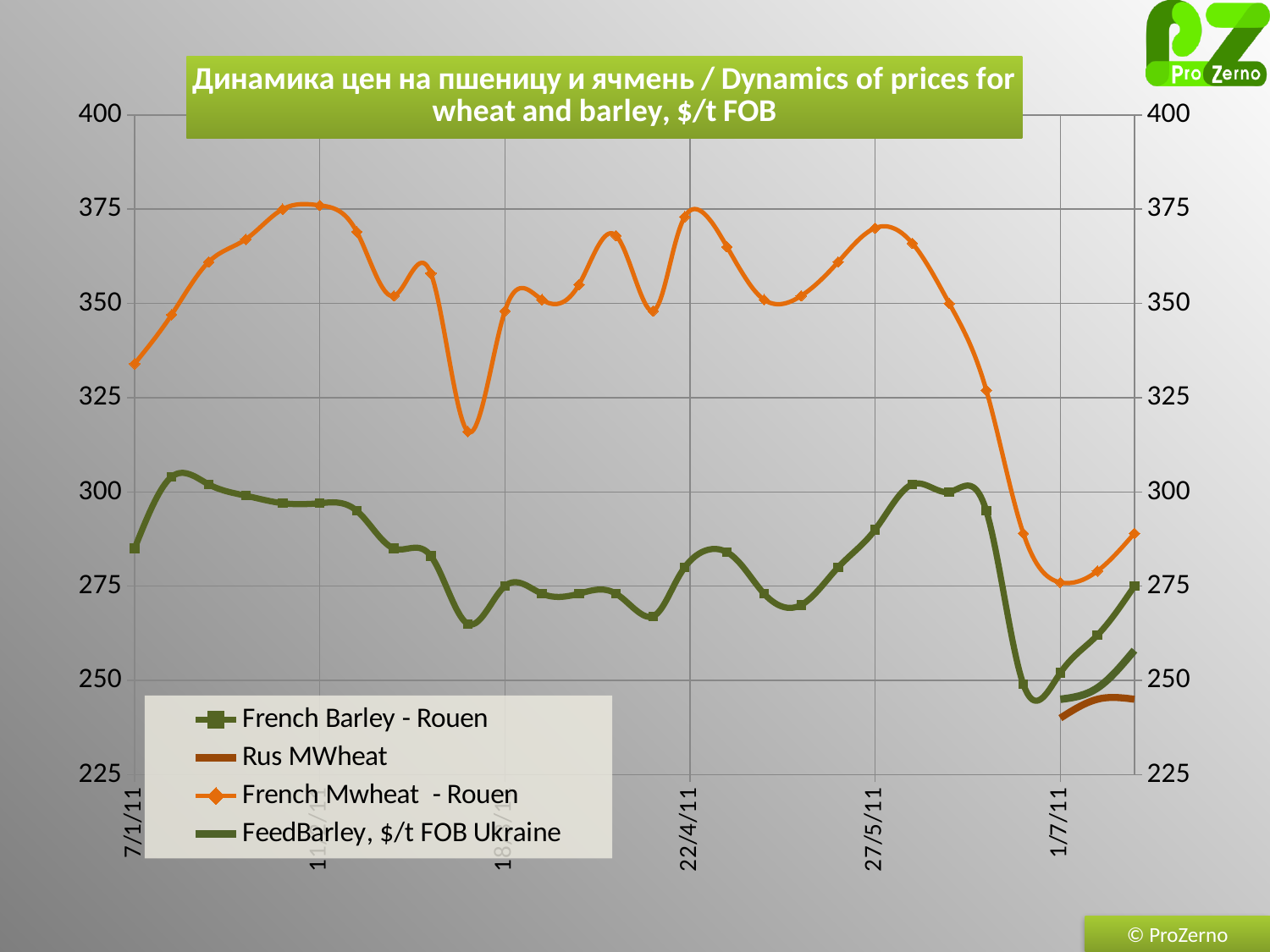
Which series has the lowest values at the right end of the chart? Rus MWheat Is the value for French Barley - Rouen at 22/4/11 greater or less than 300? less Which series has the highest values across the whole chart? French Mwheat - Rouen Is the value for French Mwheat - Rouen at 1/7/11 greater or less than 300? less What kind of chart is shown on the slide? line chart How many series does the legend list? 4 Which series does the legend list first? French Barley - Rouen What unit of price is given in the chart title? $/t FOB Is the value for French Barley - Rouen at 7/1/11 greater or less than 275? greater At 22/4/11, which is higher: French Mwheat - Rouen or French Barley - Rouen? French Mwheat - Rouen Does the French Mwheat - Rouen series rise or fall between 27/5/11 and 1/7/11? fall